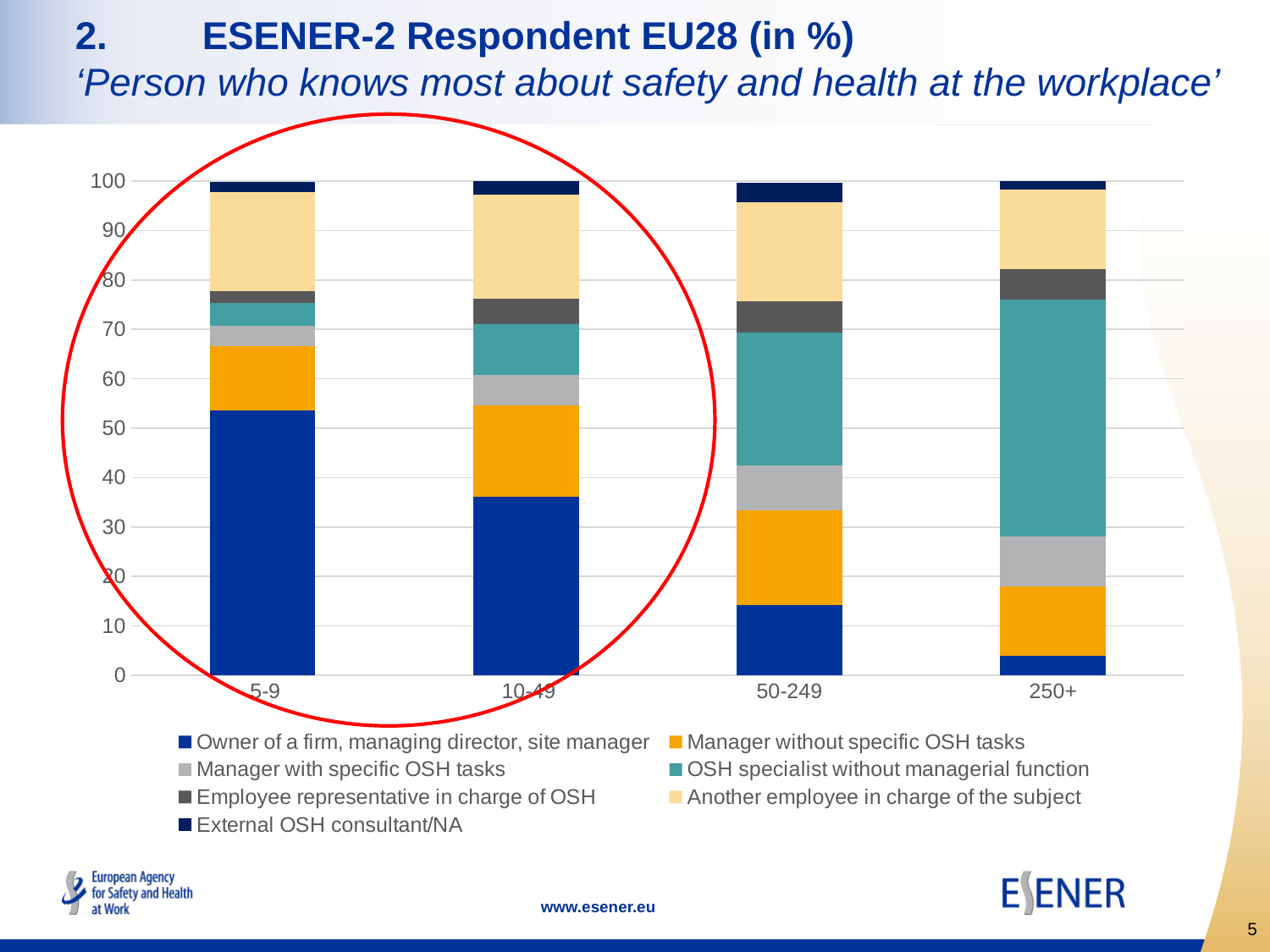
How many series does the legend list? 7 What kind of chart is shown on the slide? Stacked bar chart Is the value for 'Owner of a firm, managing director, site manager' in the 250+ category greater or less than 10? less Is the value for 'Owner of a firm, managing director, site manager' in the 5-9 category greater or less than 50? greater Which category has the smallest share for 'Owner of a firm, managing director, site manager'? 250+ Is the 'OSH specialist without managerial function' share larger in the 250+ category or in the 5-9 category? 250+ Is the value for 'Owner of a firm, managing director, site manager' in the 10-49 category greater or less than 30? greater Does the share for 'Owner of a firm, managing director, site manager' rise or fall as establishment size increases from 5-9 to 250+? Fall Which two categories are circled in red on the chart? 5-9 and 10-49 Which category has the largest share for 'Owner of a firm, managing director, site manager'? 5-9 How many establishment size categories are shown on the x axis? 4